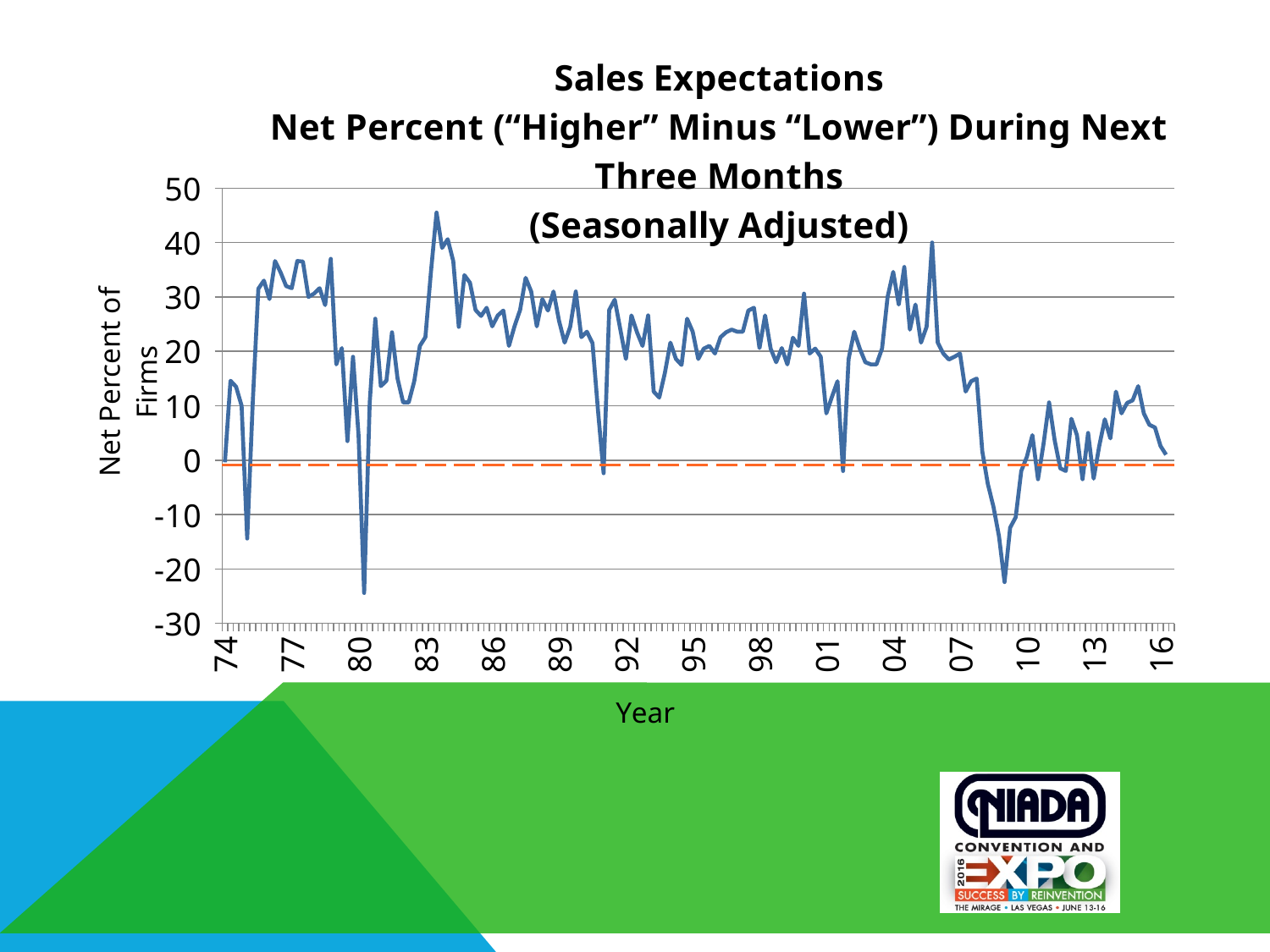
Do the values generally rise or fall from 2014 to 2016? fall What kind of chart is shown on the slide? line chart What is the first line of the chart's title? Sales Expectations Is the lowest value reached around 2009 greater or less than -20? less Is the lowest value reached around 1980 greater or less than -20? less Which dip is lower, the one around 1975 or the one around 2009? the one around 2009 Is the value at the end of the series in 2016 greater or less than 10? less Do the values generally rise or fall from 2007 to 2009? fall What is the label on the vertical axis of the chart? Net Percent of Firms